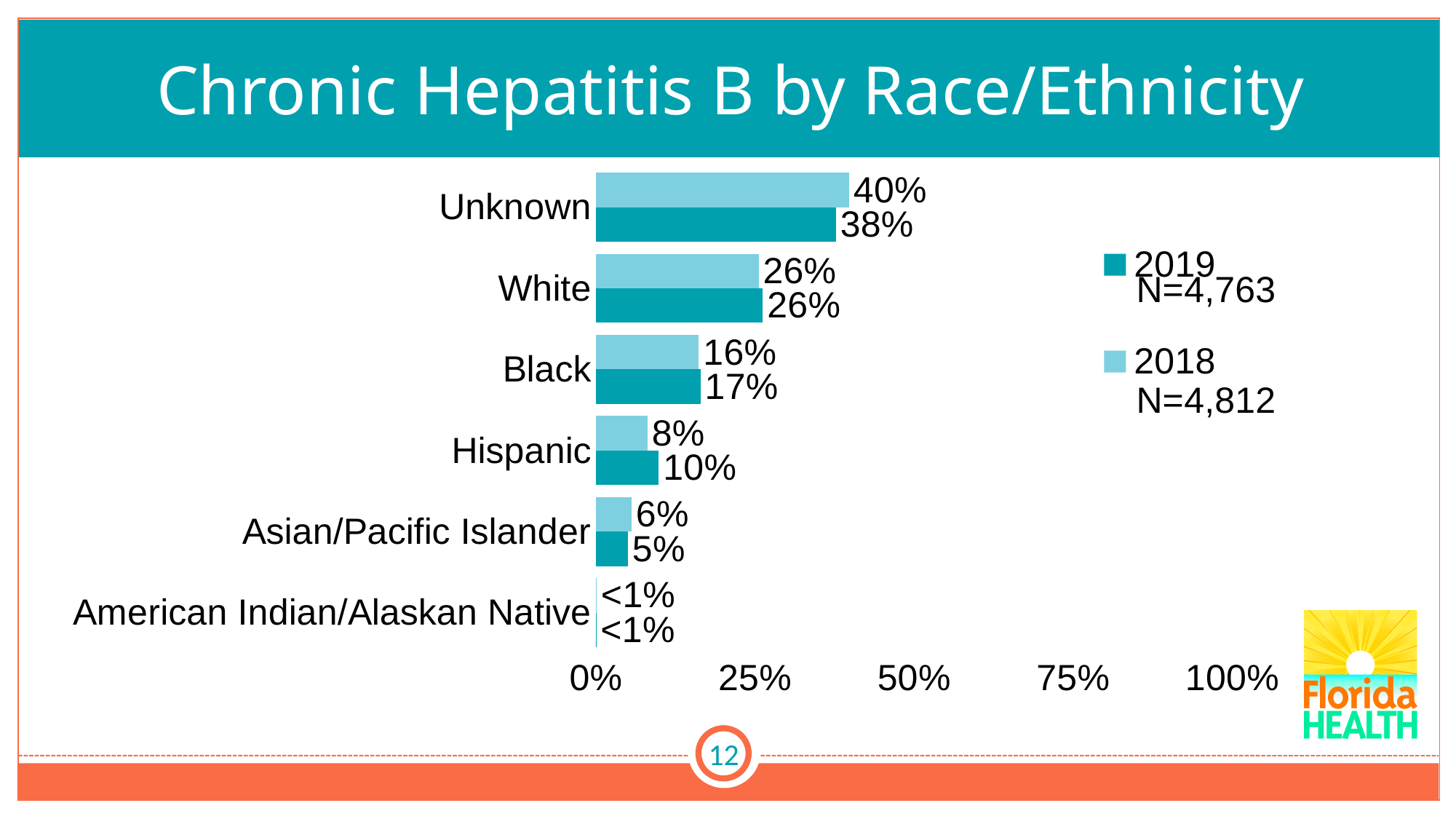
How many series does the legend list? 2 What is the 2019 value for Black? 17% What kind of chart is shown on the slide? Bar chart Which race/ethnicity category has the lowest 2018 value? American Indian/Alaskan Native Which race/ethnicity category has the highest 2019 value? Unknown What is the N value shown in the legend for 2018? N=4,812 What is the 2019 value for Unknown? 38% What is the 2018 value for Asian/Pacific Islander? 6% How many race/ethnicity categories are shown on the chart? 6 What is the 2018 value for Hispanic? 8% What is the difference between the 2018 and 2019 values for Unknown? 2% Which is larger for Hispanic, the 2018 value or the 2019 value? 2019